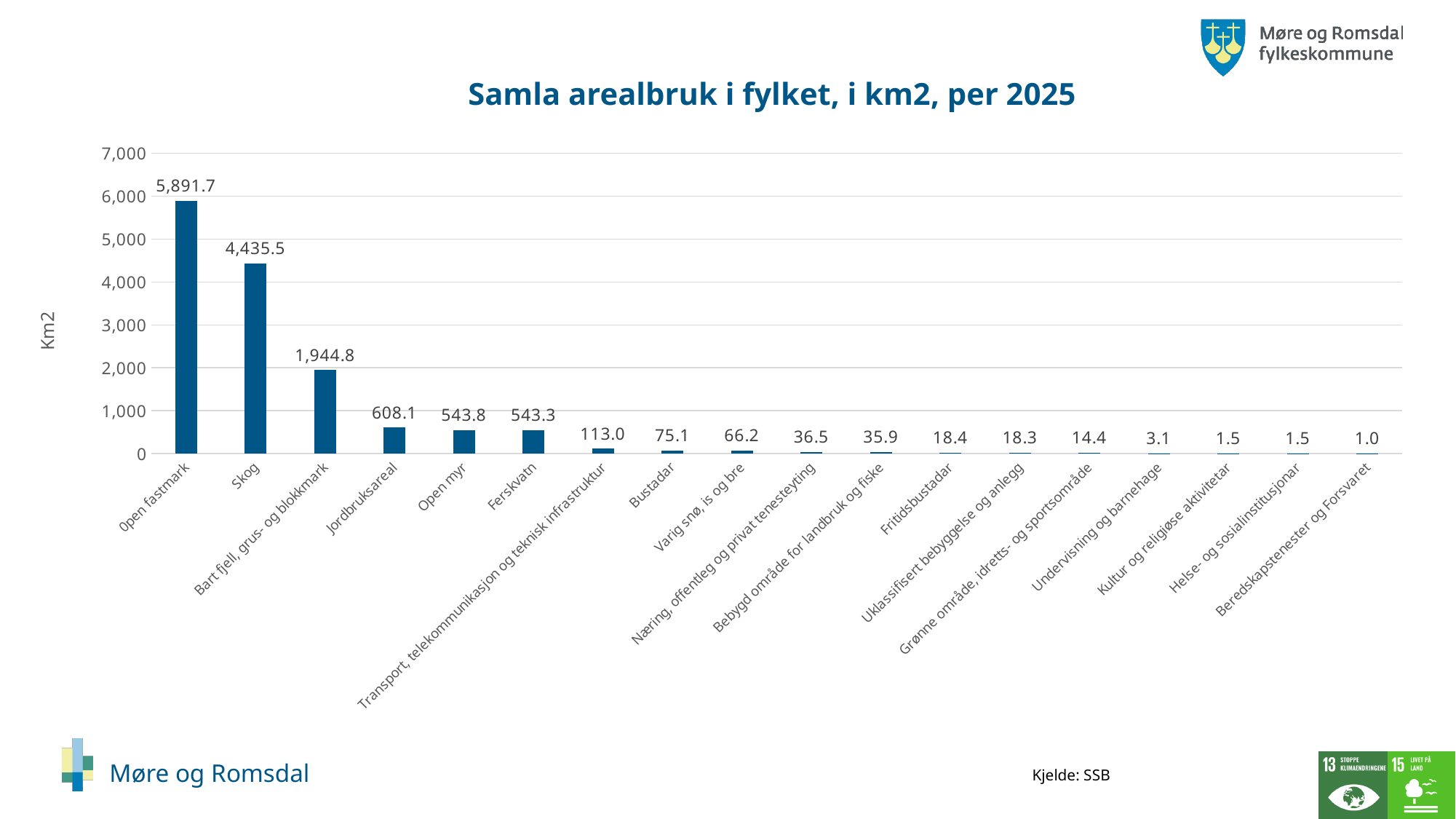
How many categories are shown on the x axis? 18 Which is larger, the value for Ferskvatn or the value for Transport, telekommunikasjon og teknisk infrastruktur? Ferskvatn What is the title of the chart? Samla arealbruk i fylket, i km2, per 2025 Which category has the lowest value? Beredskapstenester og Forsvaret What is the difference between the values for Jordbruksareal and Open myr? 64.3 What is the value for Fritidsbustadar? 18.4 What is the value for Bustadar? 75.1 What is the value for Skog? 4,435.5 What kind of chart is shown on the slide? Bar chart What is the value for Jordbruksareal? 608.1 Which category has the highest value? Open fastmark What is the difference between the values for Open fastmark and Skog? 1,456.2